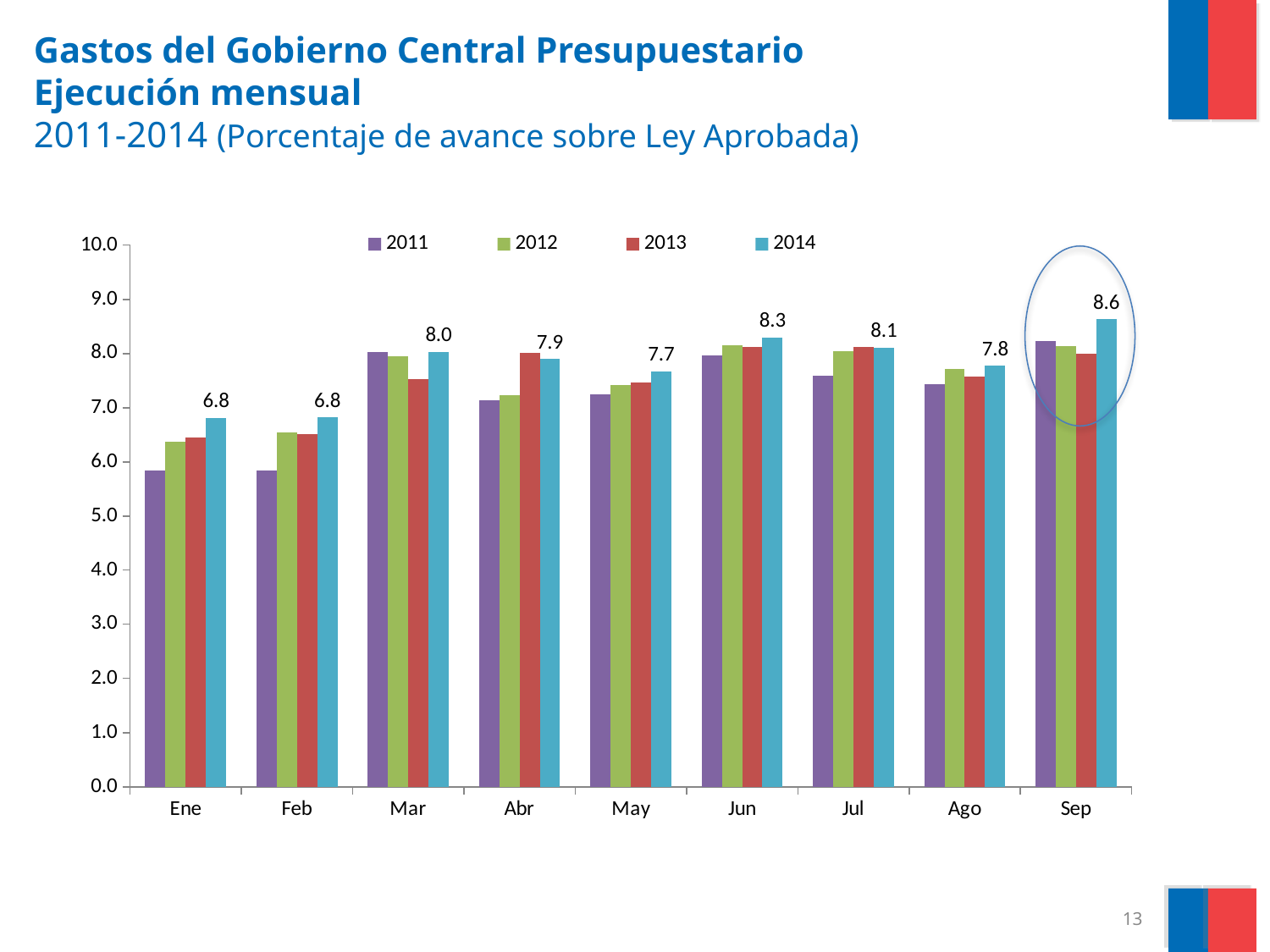
Which series has its values printed as data labels above the bars? 2014 What kind of chart is shown on the slide? bar chart Which is larger, the 2014 value for Jun or the 2014 value for Jul? Jun In which month is the 2014 value highest? Sep How many months are shown on the x axis? 9 How many series does the legend list? 4 What is the value for 2014 in Jun? 8.3 Is the value for 2011 in Ene greater or less than 6.0? less Is the value for 2013 in Abr greater or less than 7.0? greater What is the value for 2014 in Sep? 8.6 What is the value for 2014 in Abr? 7.9 What is the difference between the 2014 values for Sep and Ene? 1.8